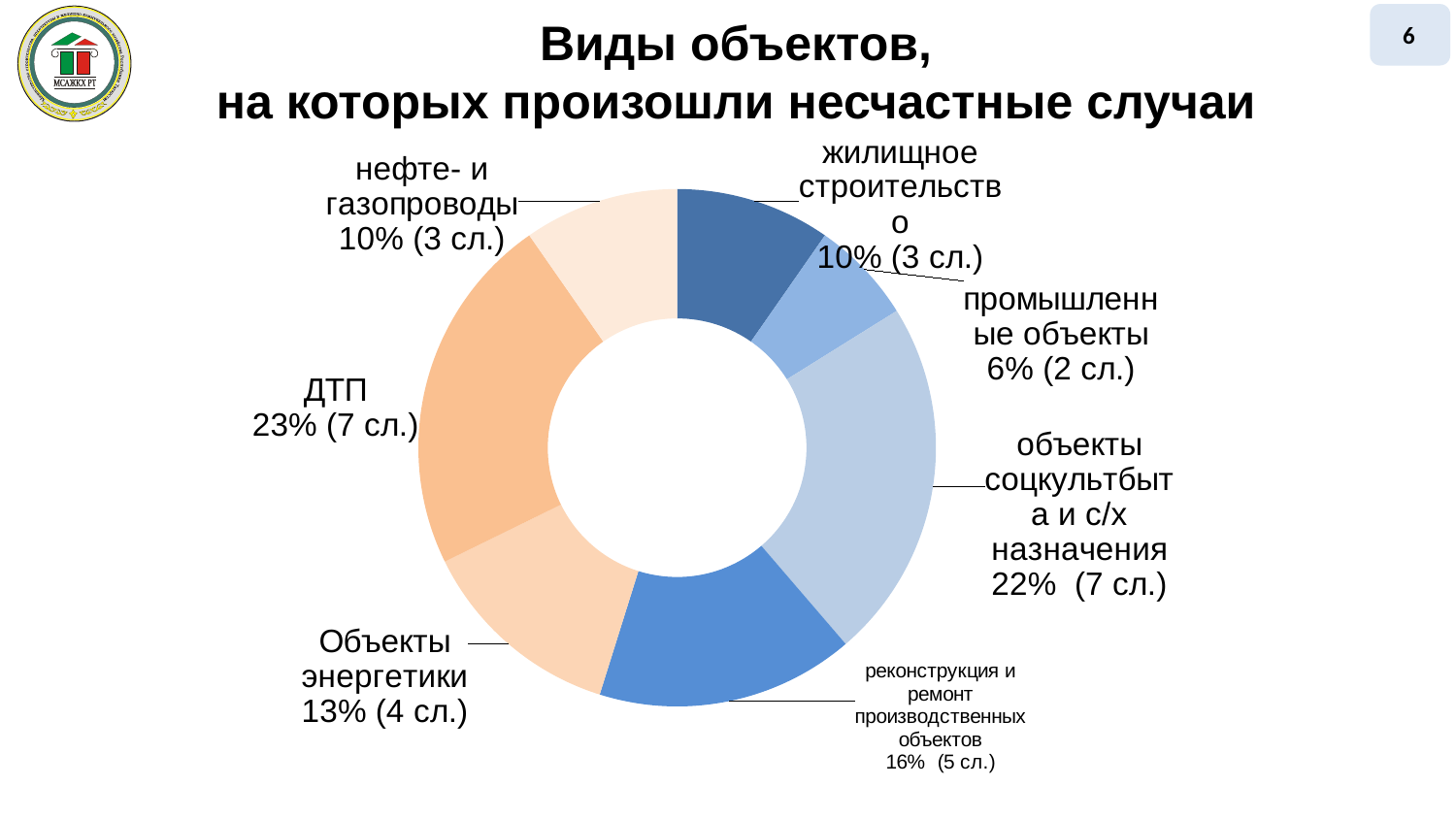
What is the difference in percentage points between ДТП and Объекты энергетики? 10 How many cases (сл.) are attributed to Объекты энергетики? 4 Which category has the largest share of accidents? ДТП What share of accidents occurred at ДТП? 23% Which is larger: the share for Объекты энергетики or for нефте- и газопроводы? Объекты энергетики What kind of chart is shown on the slide? Doughnut (pie) chart How many categories does the chart show? 7 What percentage is shown for промышленные объекты? 6% What share is shown for реконструкция и ремонт производственных объектов? 16% Which category has the smallest share of accidents? промышленные объекты How many cases (сл.) are attributed to объекты соцкультбыта и с/х назначения? 7 What is the title of the chart? Виды объектов, на которых произошли несчастные случаи